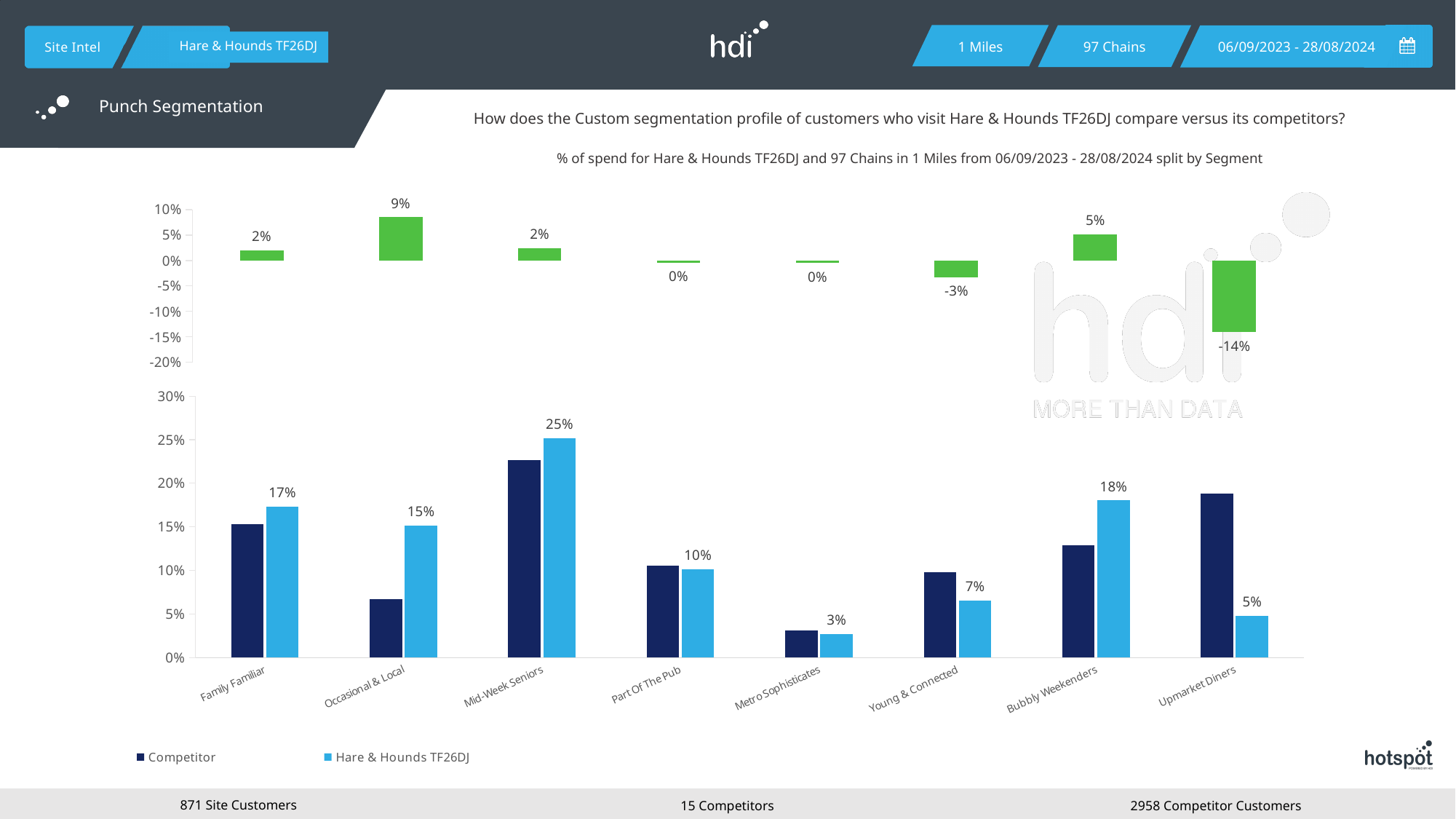
In the bottom chart, is the Competitor value for Occasional & Local greater or less than 10%? less In the top chart, which segment has the highest value? Occasional & Local In the bottom chart, is the Competitor value for Mid-Week Seniors greater or less than 20%? greater In the bottom chart, which segment has the highest Hare & Hounds TF26DJ value? Mid-Week Seniors In the bottom chart, what is the difference between the Hare & Hounds TF26DJ values for Family Familiar and Upmarket Diners? 12 percentage points In the bottom chart, what is the % of spend for Hare & Hounds TF26DJ in the Mid-Week Seniors segment? 25% In the bottom chart, for Upmarket Diners, which is larger: the Competitor value or the Hare & Hounds TF26DJ value? Competitor In the bottom chart, what is the % of spend for Hare & Hounds TF26DJ in the Bubbly Weekenders segment? 18% In the top chart, what is the value shown for Upmarket Diners? -14% In the bottom chart, which segment has the lowest Hare & Hounds TF26DJ value? Metro Sophisticates How many series does the legend of the bottom chart list? 2 How many segments are shown on the x axis of the bottom chart? 8